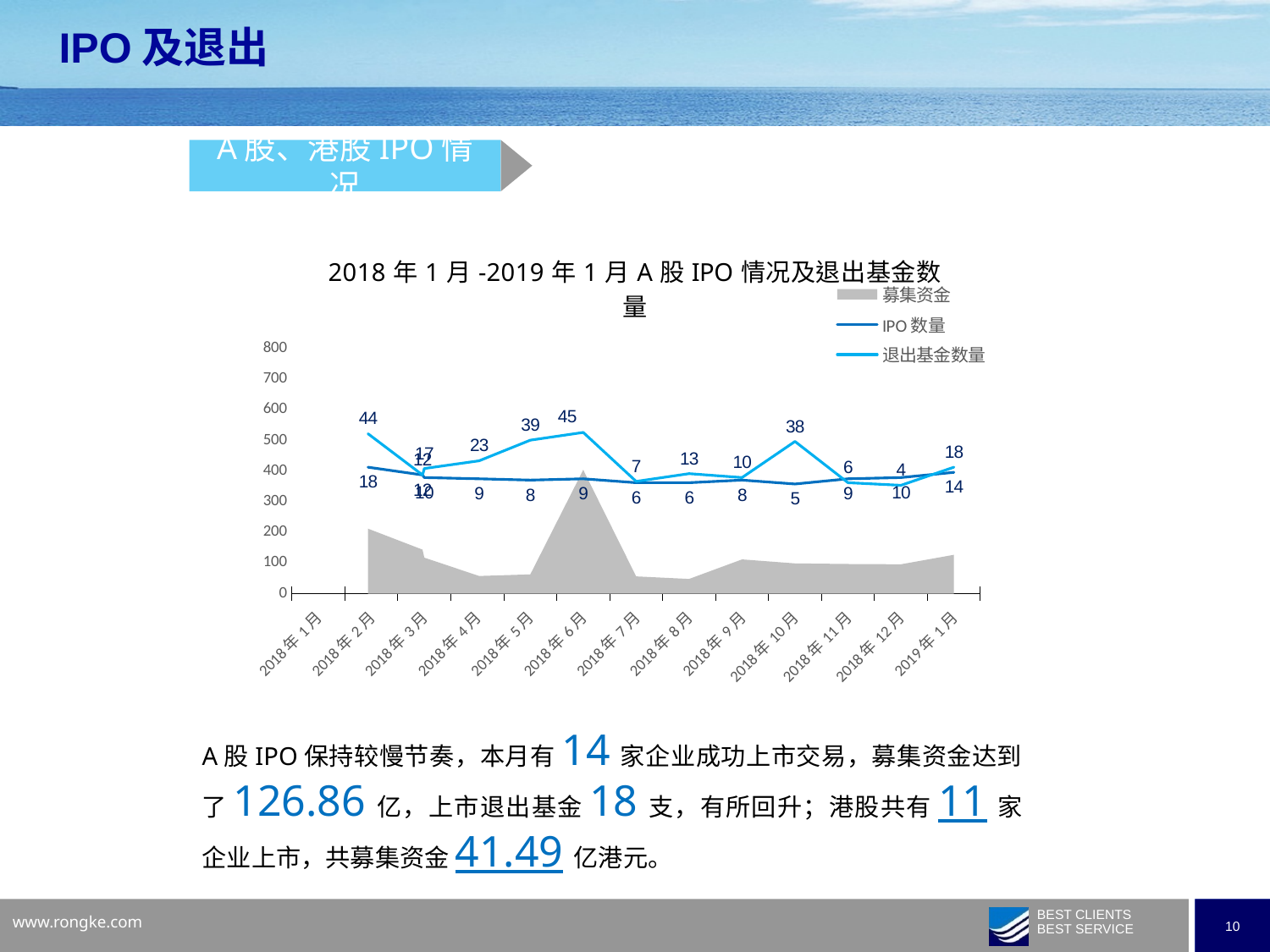
What is the IPO 数量 value for 2019年1月? 14 Is the 募集资金 value for 2018年6月 greater or less than 300? greater Which month has the lowest IPO 数量? 2018年10月 Does the IPO 数量 rise or fall from 2018年10月 to 2019年1月? rise What is the 退出基金数量 value for 2018年6月? 45 Which month has the lowest 退出基金数量? 2018年12月 What is the 退出基金数量 value for 2018年10月? 38 How many series does the legend list? 3 In 2018年10月, which is larger: IPO 数量 or 退出基金数量? 退出基金数量 Which month has the highest 退出基金数量? 2018年6月 What is the difference between the 退出基金数量 for 2018年6月 and 2018年7月? 38 Which series is shown as a gray shaded area? 募集资金